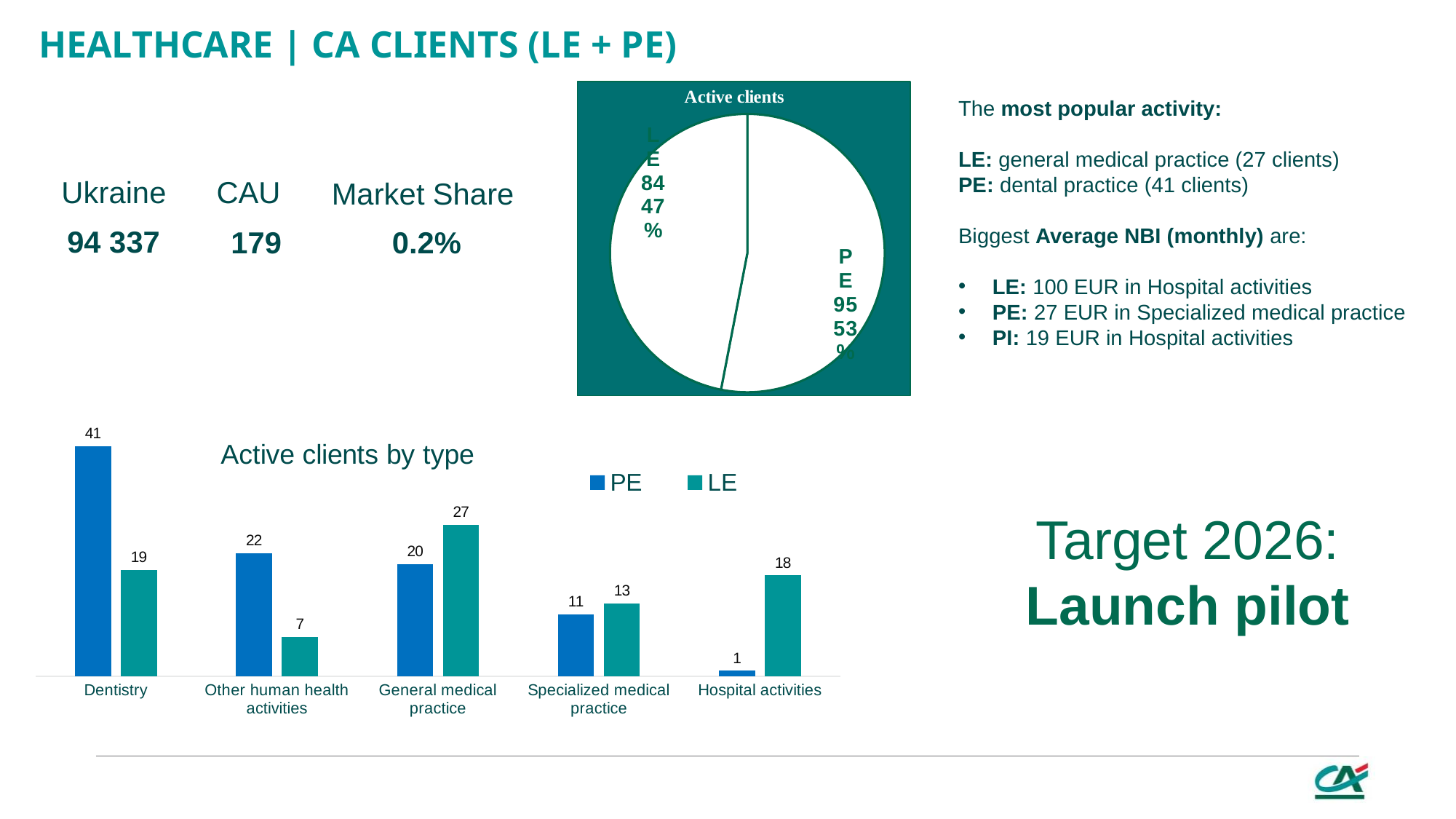
In the 'Active clients by type' chart, which is larger for Specialized medical practice, PE or LE? LE How many series does the legend of the 'Active clients by type' chart list? 2 In the 'Active clients by type' chart, what is the PE value for Dentistry? 41 In the 'Active clients' pie chart, what share of active clients is PE? 53% In the 'Active clients by type' chart, what is the LE value for General medical practice? 27 In the 'Active clients by type' chart, which category has the lowest LE value? Other human health activities In the 'Active clients' pie chart, how many LE clients are shown? 84 What kind of chart is 'Active clients by type'? Bar chart In the 'Active clients by type' chart, what is the PE value for Hospital activities? 1 In the 'Active clients by type' chart, which category has the highest PE value? Dentistry How many categories are shown in the 'Active clients by type' chart? 5 In the 'Active clients by type' chart, what is the difference between the PE and LE values for Dentistry? 22